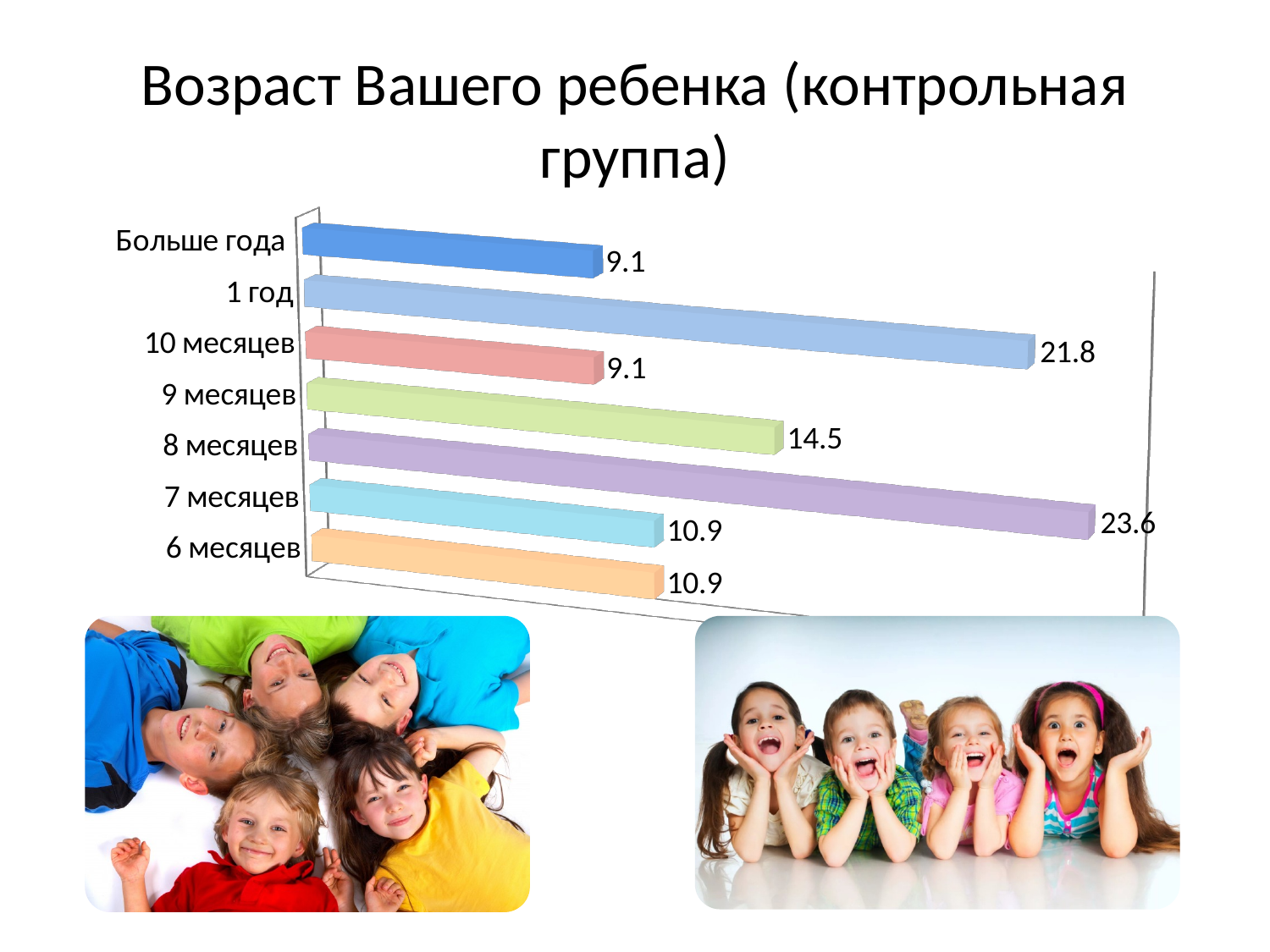
Which is larger, the value for "9 месяцев" or the value for "10 месяцев"? 9 месяцев What is the title of the chart? Возраст Вашего ребенка (контрольная группа) What is the difference between the values for "8 месяцев" and "1 год"? 1.8 What is the value for "9 месяцев"? 14.5 Which category has the highest value? 8 месяцев Which is larger, the value for "1 год" or the value for "6 месяцев"? 1 год What is the value for "8 месяцев"? 23.6 How many categories are shown in the chart? 7 What kind of chart is shown on the slide? Bar chart What is the difference between the values for "9 месяцев" and "7 месяцев"? 3.6 What is the value for "Больше года"? 9.1 What is the value for "1 год"? 21.8